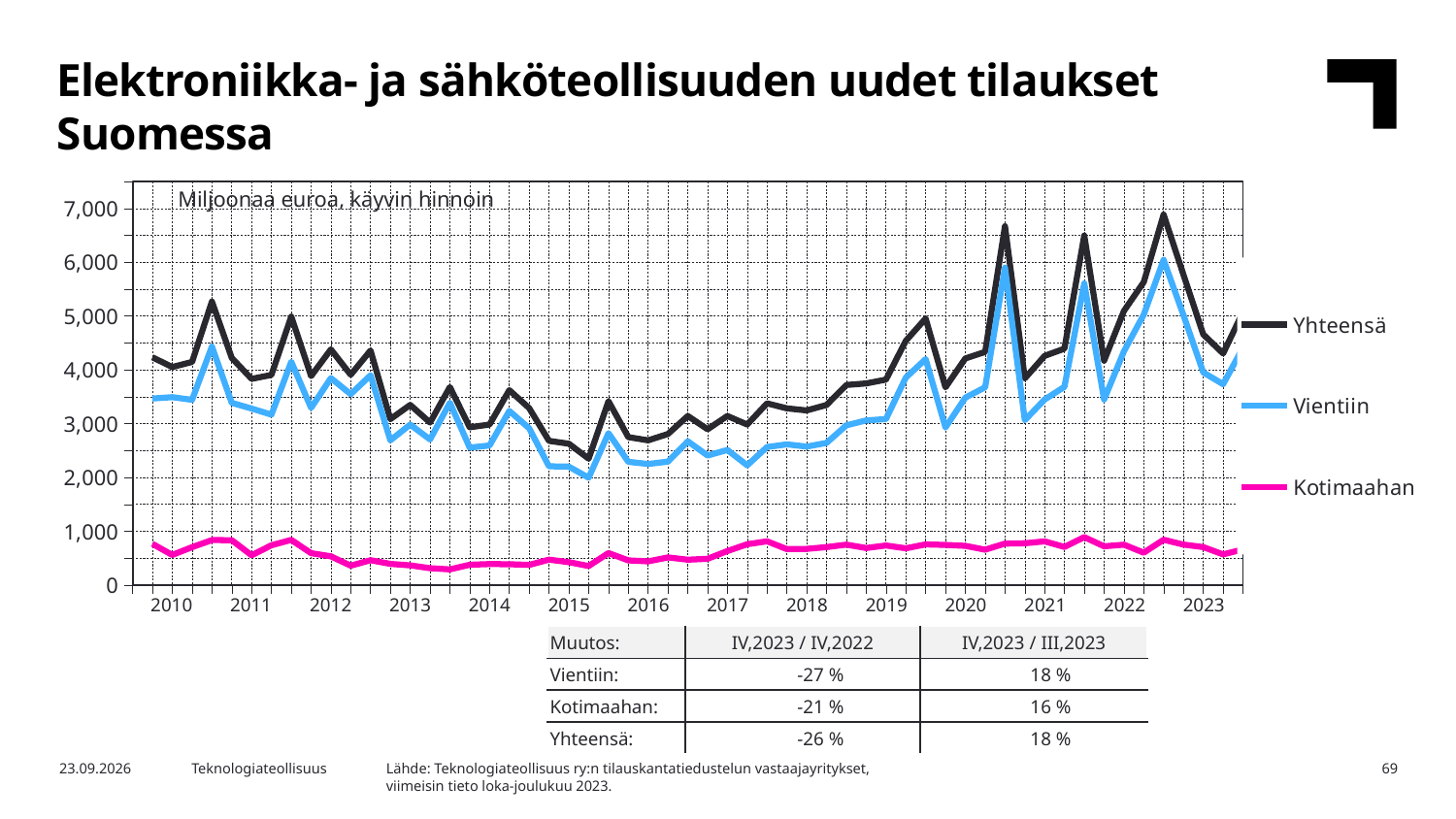
Which series has the highest values throughout the chart? Yhteensä What kind of chart is shown on the slide? Line chart Does the Yhteensä series generally rise or fall from 2010 to 2015? fall Which series has the lowest values throughout the chart? Kotimaahan Is the value for Kotimaahan in 2015 greater or less than 1,000? less Is the value for Vientiin in 2015 greater or less than 3,000? less How many series does the legend list? 3 Is the peak value for Yhteensä in 2022 greater or less than 6,000? greater Which is larger in 2018, Vientiin or Kotimaahan? Vientiin How many years are labelled on the x axis? 14 Which series are listed in the chart legend? Yhteensä, Vientiin, Kotimaahan What unit is stated at the top of the chart? Miljoonaa euroa, käyvin hinnoin